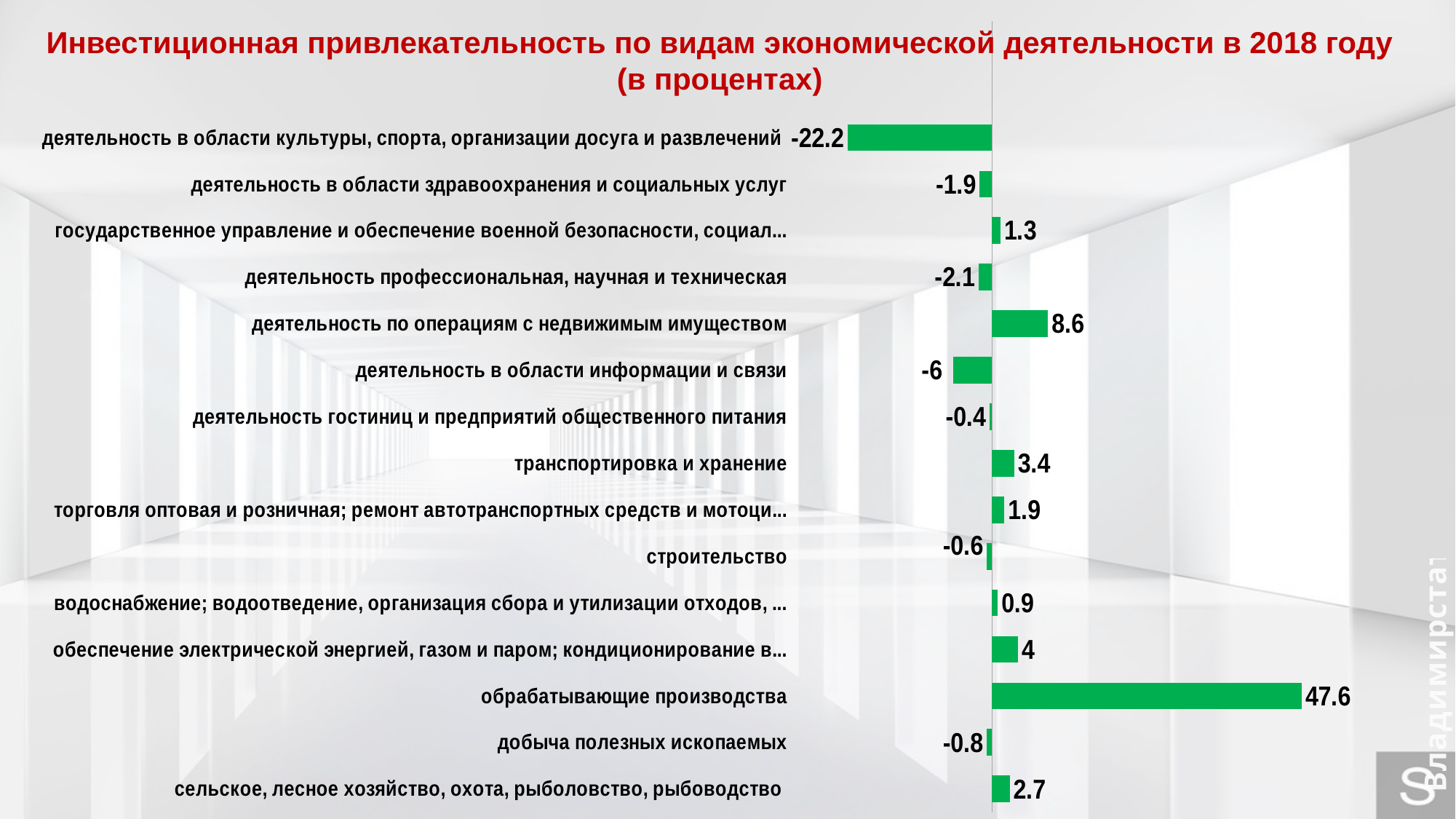
What is the title of the chart? Инвестиционная привлекательность по видам экономической деятельности в 2018 году (в процентах) Which category has the highest value? обрабатывающие производства What is the value for транспортировка и хранение? 3.4 What is the difference between the values for деятельность по операциям с недвижимым имуществом and транспортировка и хранение? 5.2 Which is larger: the value for транспортировка и хранение or the value for сельское, лесное хозяйство, охота, рыболовство, рыбоводство? транспортировка и хранение Which category has the lowest value? деятельность в области культуры, спорта, организации досуга и развлечений What is the value for обрабатывающие производства? 47.6 What is the value for сельское, лесное хозяйство, охота, рыболовство, рыбоводство? 2.7 What is the value for деятельность в области информации и связи? -6 What is the difference between the values for обрабатывающие производства and деятельность по операциям с недвижимым имуществом? 39 What type of chart is shown on the slide? bar chart How many categories are shown in the chart? 15